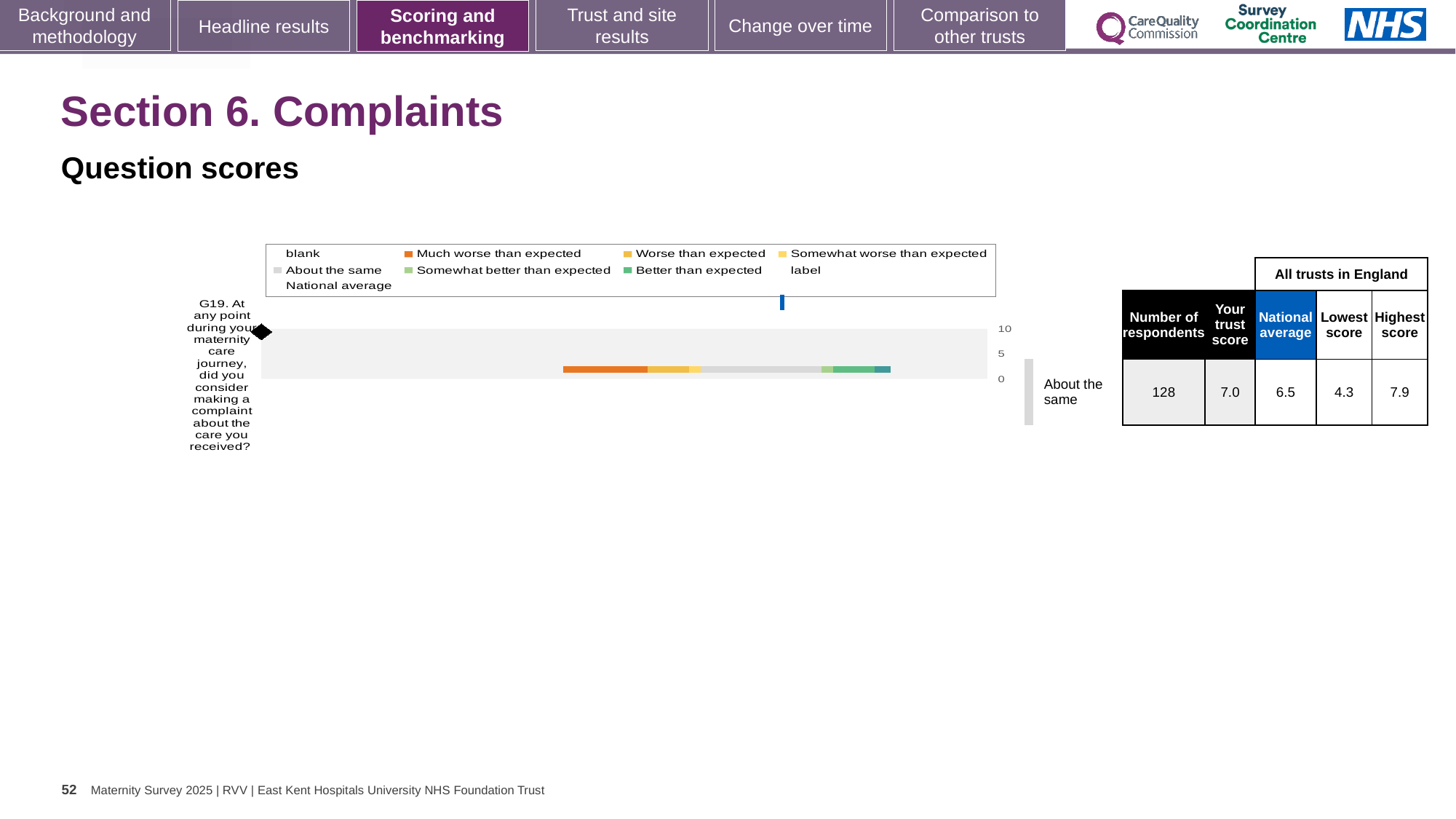
How many respondents answered question G19? 128 What kind of chart is shown on the slide? bar chart What is the difference between the highest score and the lowest score for question G19? 3.6 What is the lowest score among all trusts in England for question G19? 4.3 What benchmark rating is given for question G19 on the chart? About the same Is the trust score for question G19 larger or smaller than the national average? larger What is the national average for question G19 according to the table next to the chart? 6.5 What is the highest tick value shown on the chart's axis? 10 What is the trust's score for question G19 according to the table next to the chart? 7.0 How many question categories are plotted on the chart? 1 Which question is plotted on the chart? G19. At any point during your maternity care journey, did you consider making a complaint about the care you received? What is the highest score among all trusts in England for question G19? 7.9